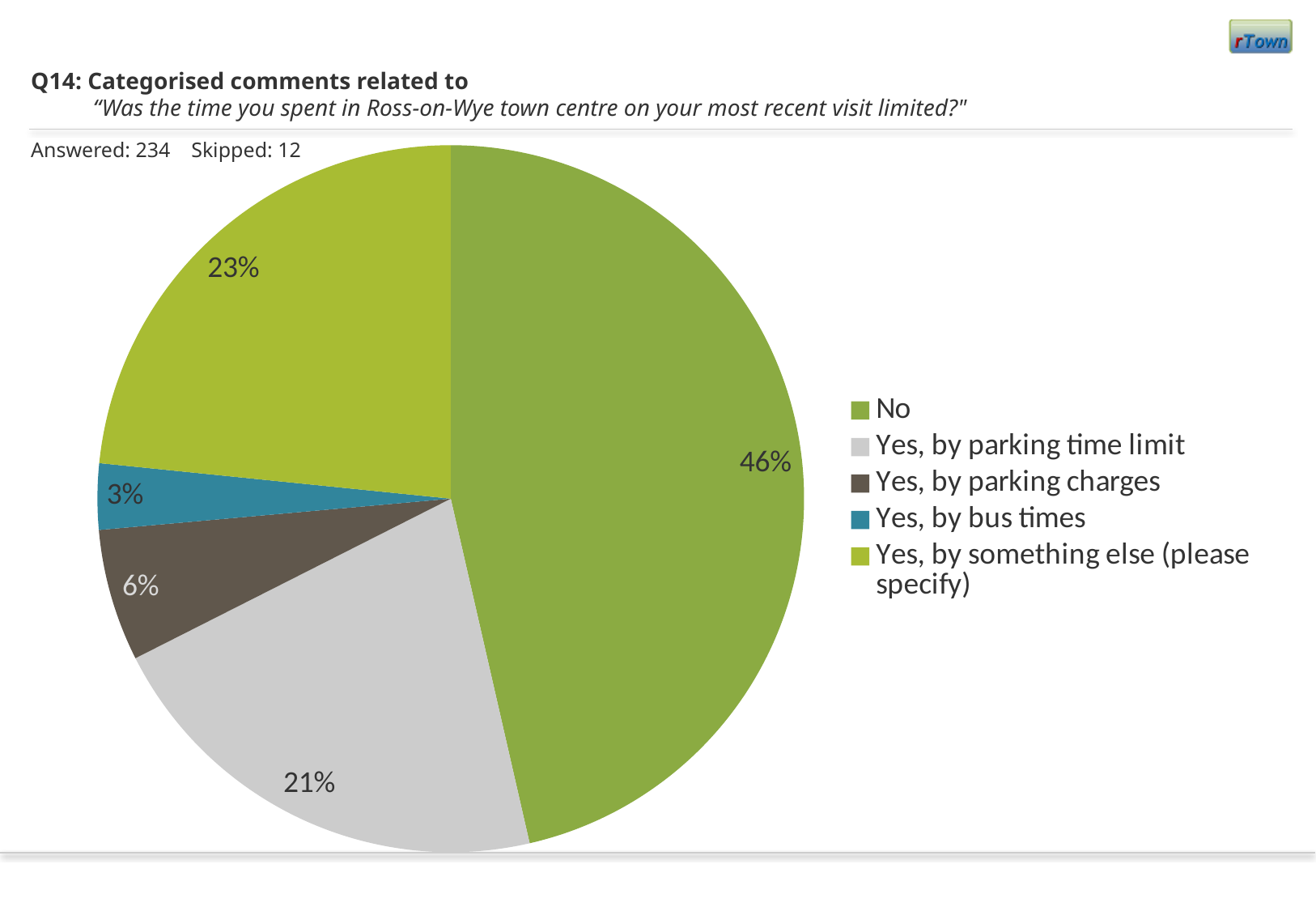
Which category has the largest slice of the pie? No How many categories does the pie chart have? 5 What share of the pie is the "No" slice? 46% Which is larger: "Yes, by something else (please specify)" or "Yes, by parking time limit"? Yes, by something else (please specify) What kind of chart is shown on the slide? pie chart What percentage is shown for "Yes, by parking time limit"? 21% How many respondents answered this question according to the slide? 234 What percentage is shown for "Yes, by bus times"? 3% Which category has the smallest slice of the pie? Yes, by bus times What is the difference in percentage points between "No" and "Yes, by parking time limit"? 25 What percentage is shown for "Yes, by something else (please specify)"? 23% What percentage is shown for "Yes, by parking charges"? 6%